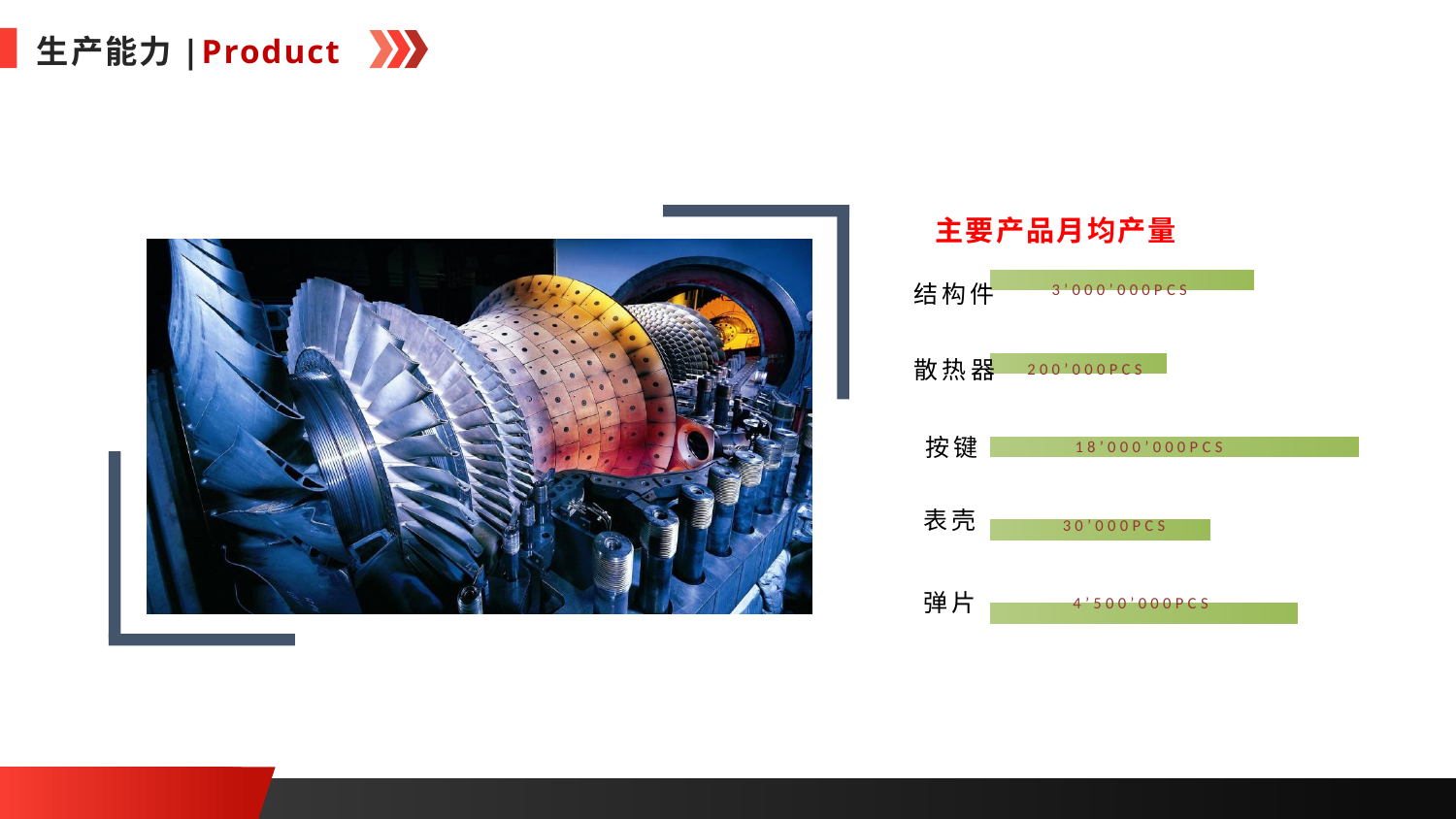
Which has a higher monthly average output, 结构件 or 弹片? 弹片 Which has a higher monthly average output, 按键 or 结构件? 按键 What is the difference between the monthly output of 弹片 and 结构件? 1'500'000PCS What is the monthly average output for 按键? 18'000'000PCS How many product categories are shown in the chart? 5 What is the monthly average output for 表壳? 30'000PCS What is the title of the chart? 主要产品月均产量 What is the monthly average output for 弹片? 4'500'000PCS What kind of chart is shown on the slide? Bar chart What is the monthly average output for 散热器? 200'000PCS Which product has the highest monthly average output? 按键 What is the monthly average output for 结构件? 3'000'000PCS